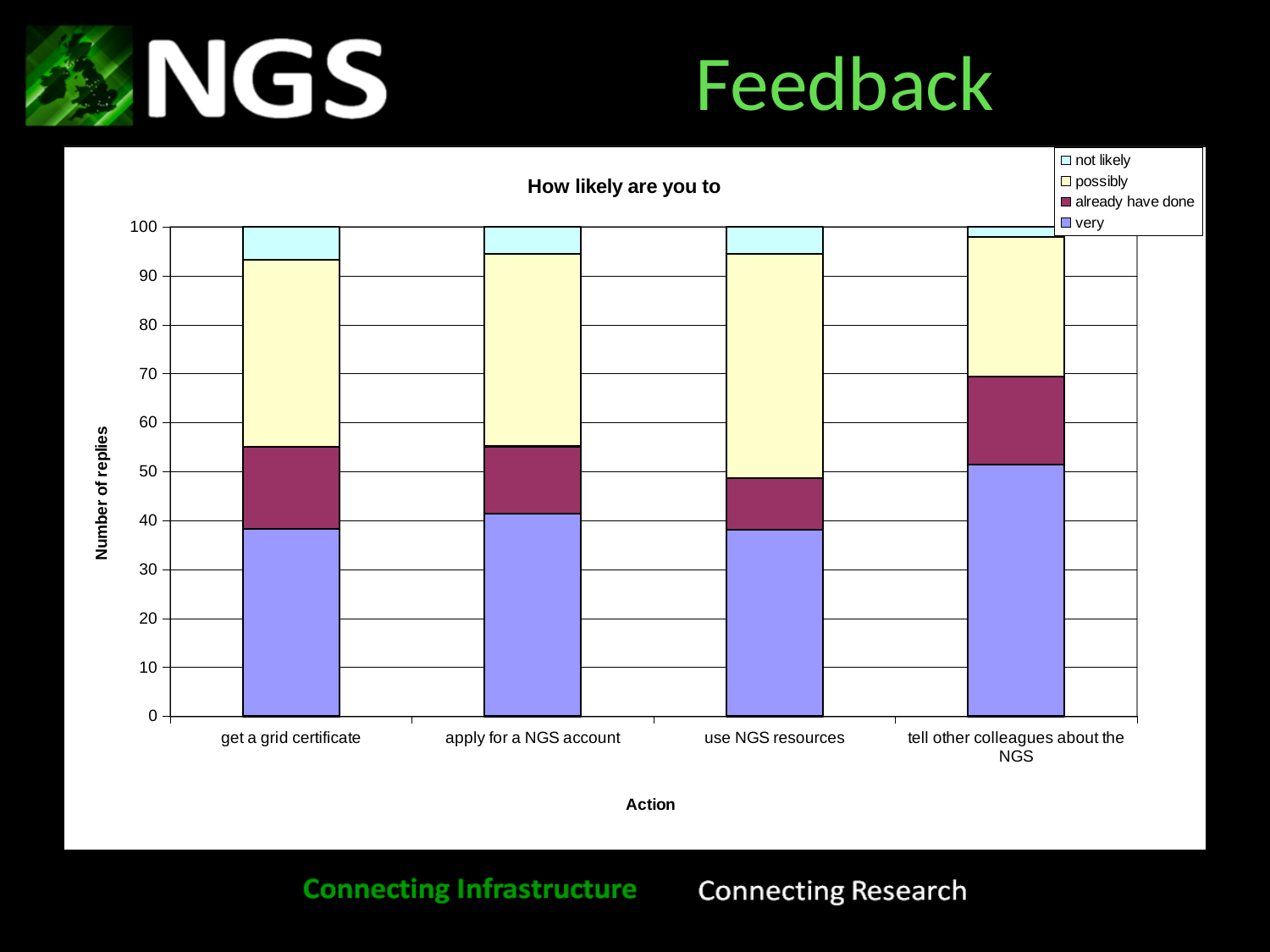
How many actions (categories) are shown on the x axis? 4 Which has a larger 'very' segment: 'get a grid certificate' or 'tell other colleagues about the NGS'? tell other colleagues about the NGS For which action is the 'very' segment the largest? tell other colleagues about the NGS For which action is the 'possibly' segment the largest? use NGS resources What is the title of the chart? How likely are you to Is the 'very' value for 'tell other colleagues about the NGS' greater or less than 40? greater Is the 'very' value for 'apply for a NGS account' greater or less than 50? less What kind of chart is shown on the slide? stacked bar chart How many series does the legend list? 4 For which action is the 'possibly' segment the smallest? tell other colleagues about the NGS What is the label of the vertical axis? Number of replies For which action is the 'not likely' segment the smallest? tell other colleagues about the NGS